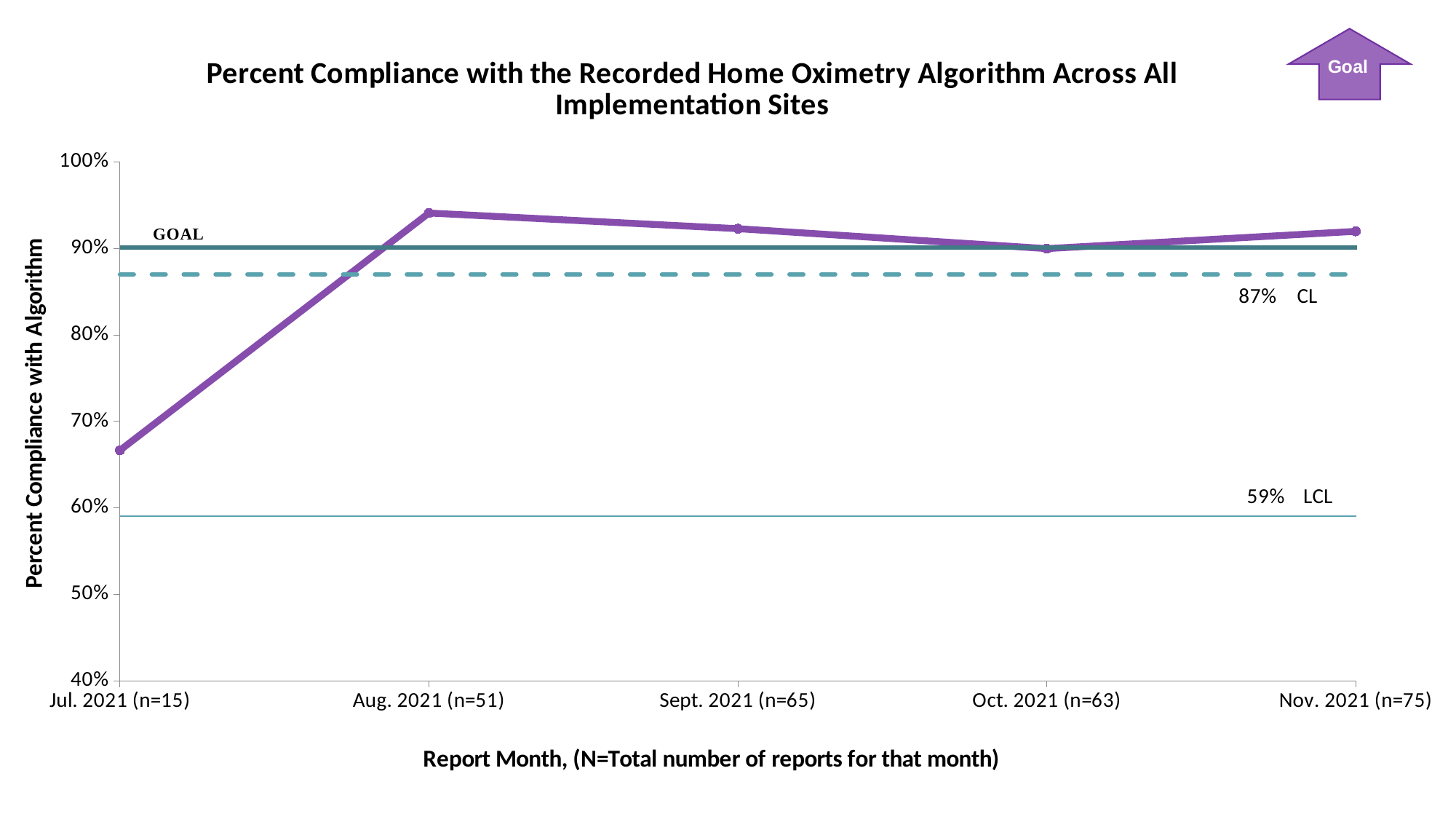
What is the title of the chart? Percent Compliance with the Recorded Home Oximetry Algorithm Across All Implementation Sites How many report months are plotted on the x axis? 5 Is the percent compliance for Aug. 2021 greater or less than 90%? greater Which report month has the lowest percent compliance with the algorithm? Jul. 2021 (n=15) Which report month has the highest percent compliance with the algorithm? Aug. 2021 (n=51) Which has higher percent compliance, Jul. 2021 or Nov. 2021? Nov. 2021 Is the percent compliance for Sept. 2021 greater or less than 90%? greater What value is labelled as the LCL on the chart? 59% What kind of chart is shown on the slide? line chart Is the percent compliance for Jul. 2021 greater or less than 70%? less Does percent compliance rise or fall from Jul. 2021 to Aug. 2021? rise What value is labelled as the CL (center line) on the chart? 87%